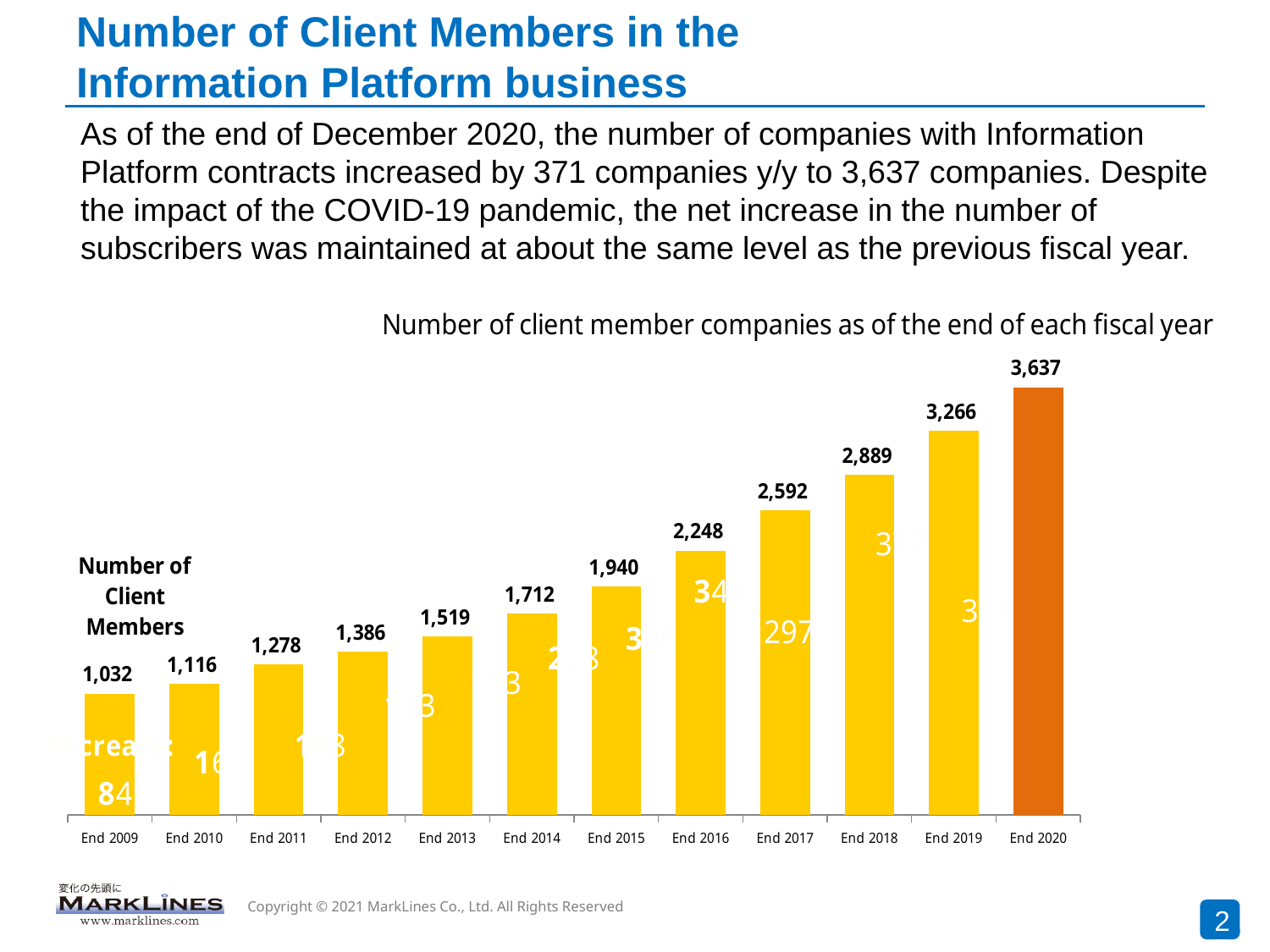
Do the number of client members rise or fall from End 2009 to End 2020? Rise Which fiscal year end has the lowest number of client members? End 2009 What is the number of client members at End 2020? 3,637 What is the difference in client members between End 2020 and End 2019? 371 How many fiscal year ends are shown on the x axis? 12 What is the difference in client members between End 2017 and End 2016? 344 What is the number of client members at End 2015? 1,940 What is the number of client members at End 2009? 1,032 Which has more client members, End 2013 or End 2014? End 2014 What kind of chart is shown on the slide? Bar chart What is the number of client members at End 2018? 2,889 Which fiscal year end has the highest number of client members? End 2020